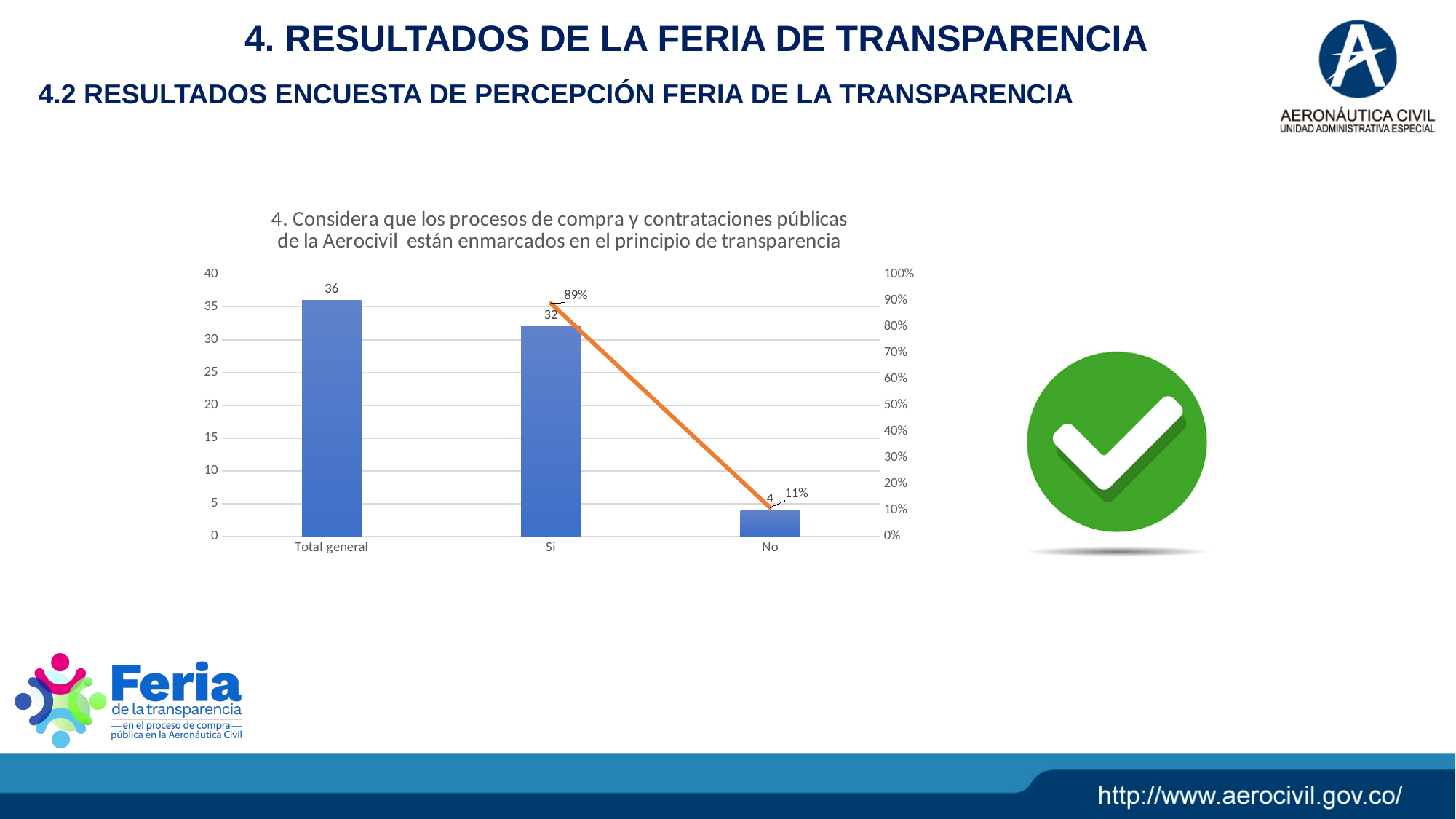
Do the bar values rise or fall from left to right along the x axis? fall What is the value of the bar for No? 4 What is the value of the bar for Si? 32 What is the value of the bar for Total general? 36 Which has a larger bar value, Si or No? Si What percentage is shown on the line for No? 11% Which category has the lowest bar? No What kind of chart is used for the blue data series? bar chart What percentage is shown on the line for Si? 89% How many categories are shown on the x axis? 3 Which category has the highest bar? Total general What is the difference between the bar values for Si and No? 28